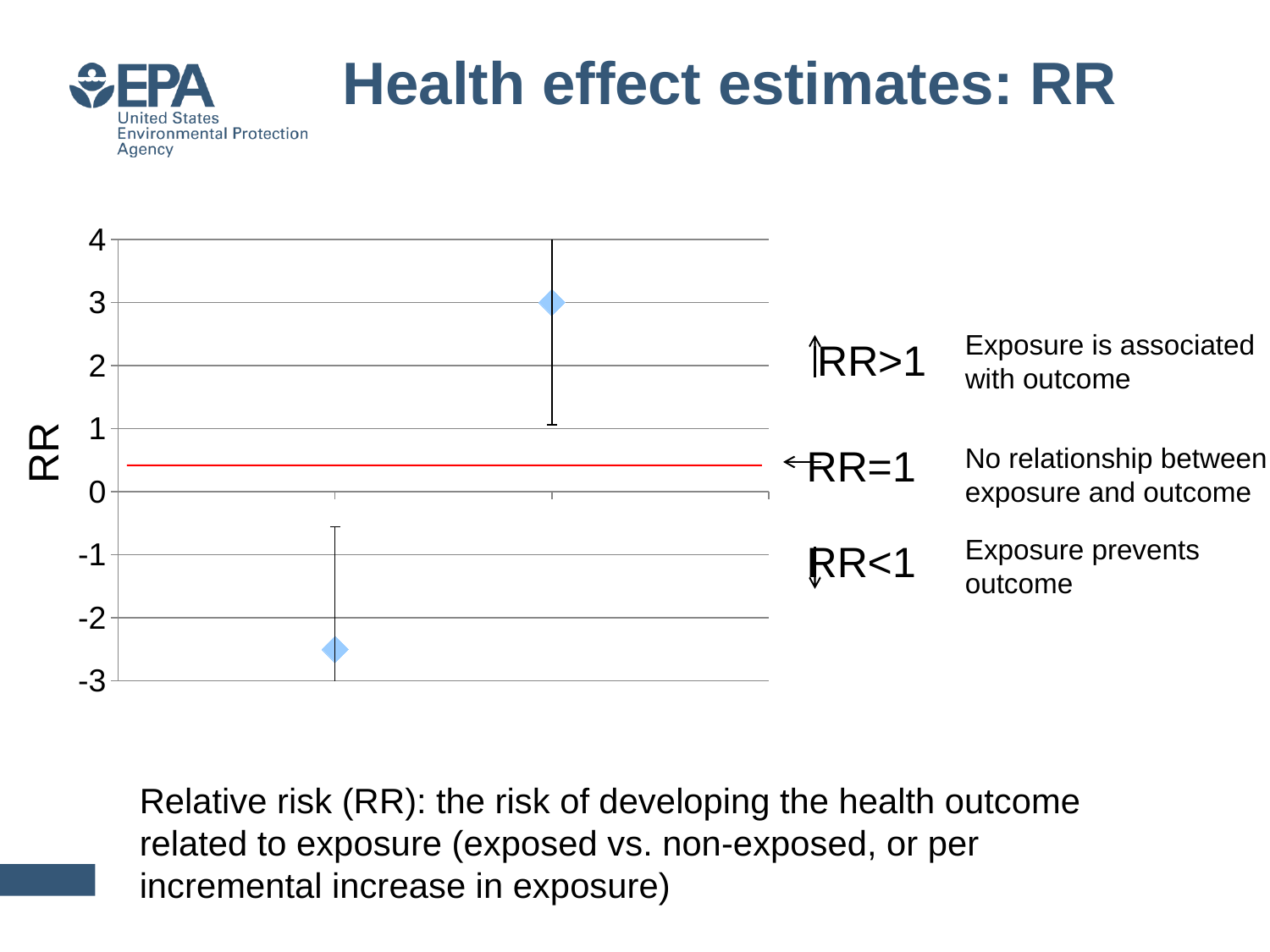
Does the upper end of the error bar on the right-hand point reach above 3? yes Is the value of the lower (left-hand) data point greater or less than -2? less What value does the upper (right-hand) data point sit on? 3 What is the highest value shown on the vertical axis of the chart? 4 Which data point has the higher value, the left-hand one or the right-hand one? the right-hand one What is the label on the vertical axis of the chart? RR Is the lower end of the error bar on the right-hand point greater or less than 0? greater How many data points are plotted on the chart? 2 What kind of chart is shown on the slide? scatter chart